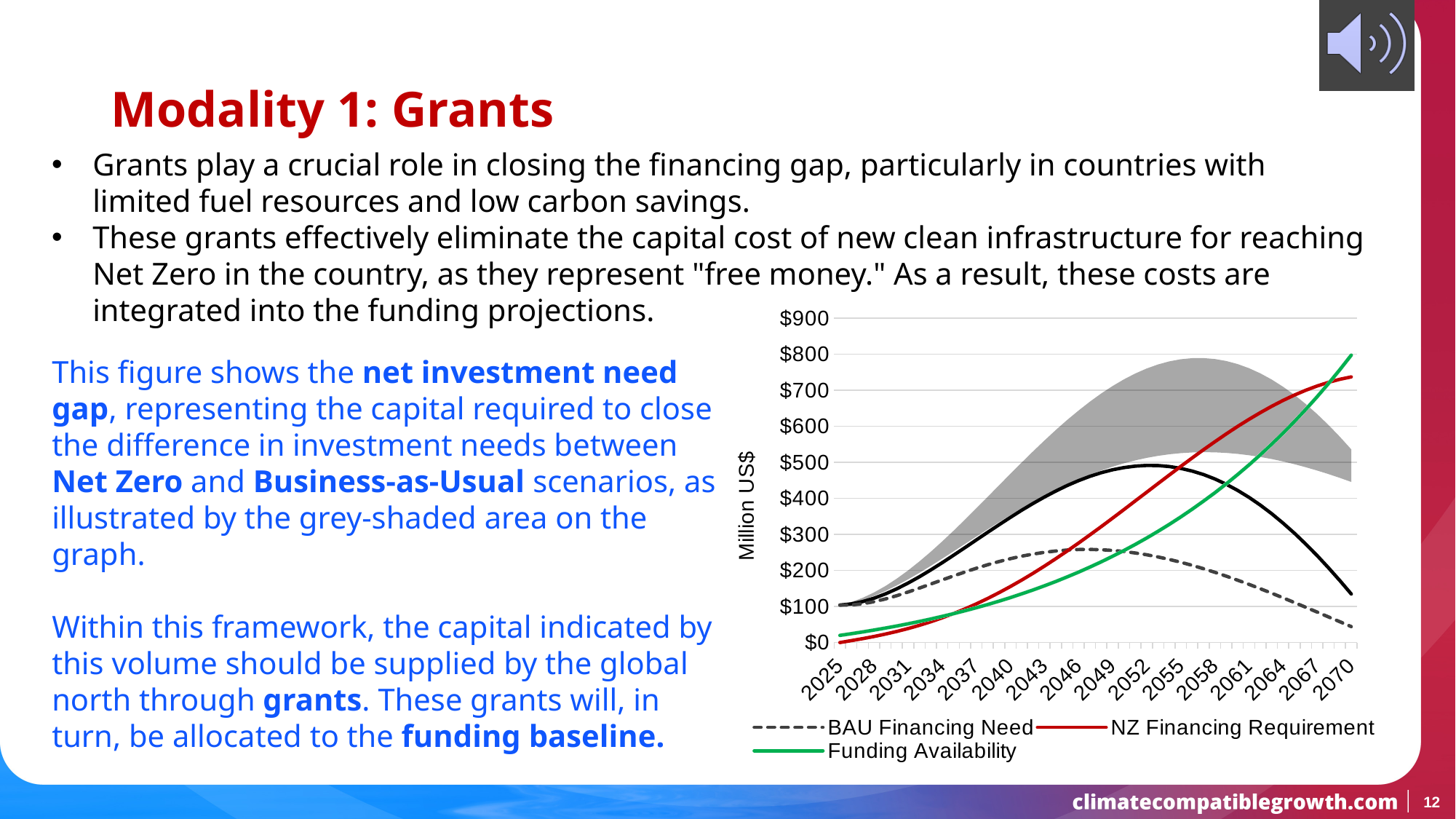
Does Funding Availability rise or fall from 2025 to 2070? rise How many series does the chart's legend list? 3 Is the value for BAU Financing Need in 2070 greater or less than $100? less In 2025, which is larger: BAU Financing Need or NZ Financing Requirement? BAU Financing Need Is the value for Funding Availability in 2070 greater or less than $700? greater Which of the three legend series has the highest value in 2070? Funding Availability What is the label on the chart's vertical axis? Million US$ Which series in the legend is drawn as a dashed line? BAU Financing Need Does BAU Financing Need rise or fall from 2049 to 2070? fall What kind of chart is shown on the slide? line chart Is the value for NZ Financing Requirement in 2070 greater or less than $700? greater